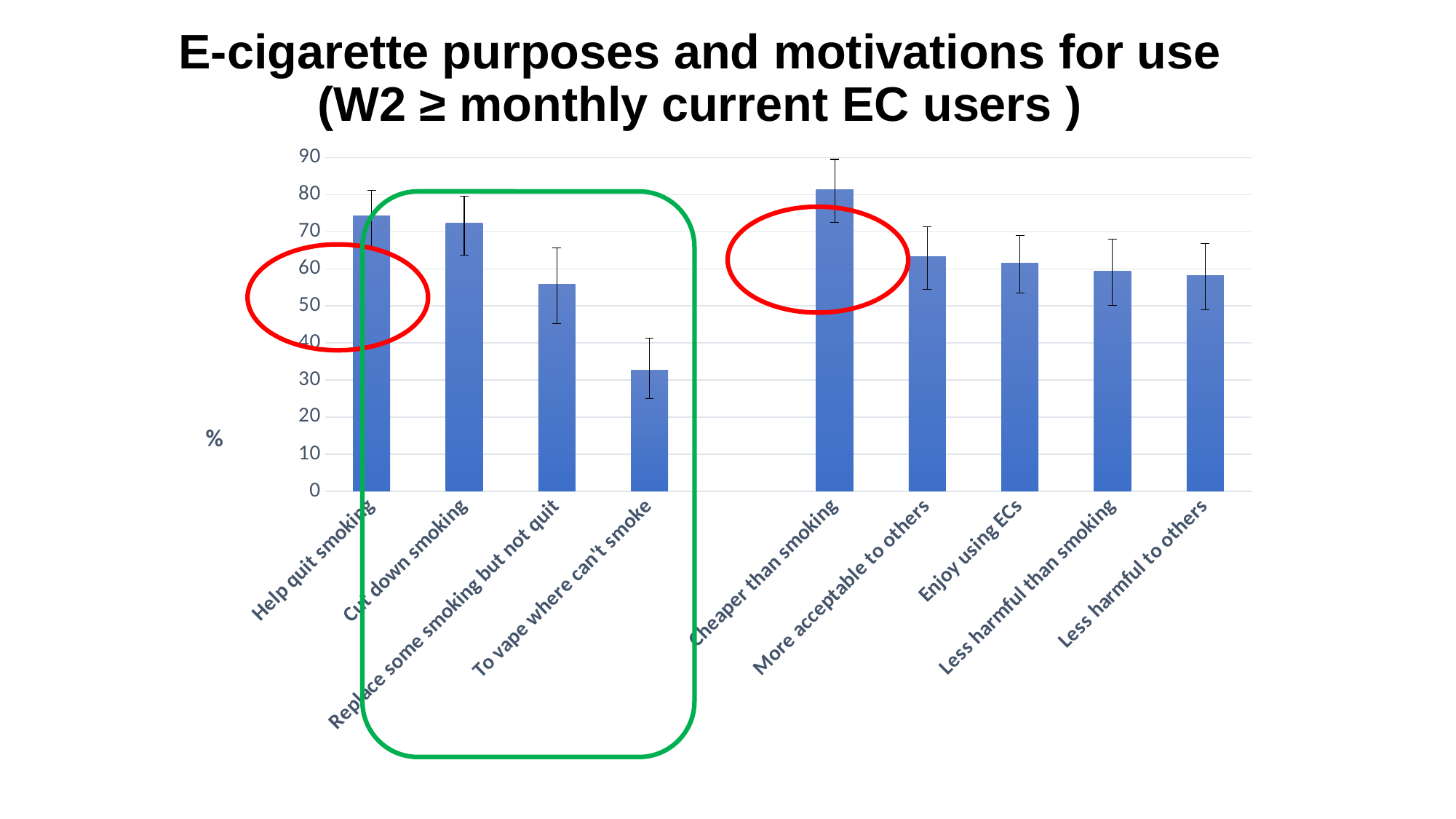
Is the value for To vape where can't smoke greater or less than 40? less Is the value for Replace some smoking but not quit greater or less than 50? greater Is the value for Help quit smoking greater or less than 70? greater What is the title of the chart? E-cigarette purposes and motivations for use (W2 ≥ monthly current EC users ) How many categories are plotted on the x axis? 9 What kind of chart is shown on the slide? Bar chart What is the label on the y axis? % Which category has the lowest value? To vape where can't smoke Which is larger, the value for Cheaper than smoking or the value for Less harmful to others? Cheaper than smoking Which is larger, the value for Help quit smoking or the value for Replace some smoking but not quit? Help quit smoking Which category has the highest value? Cheaper than smoking